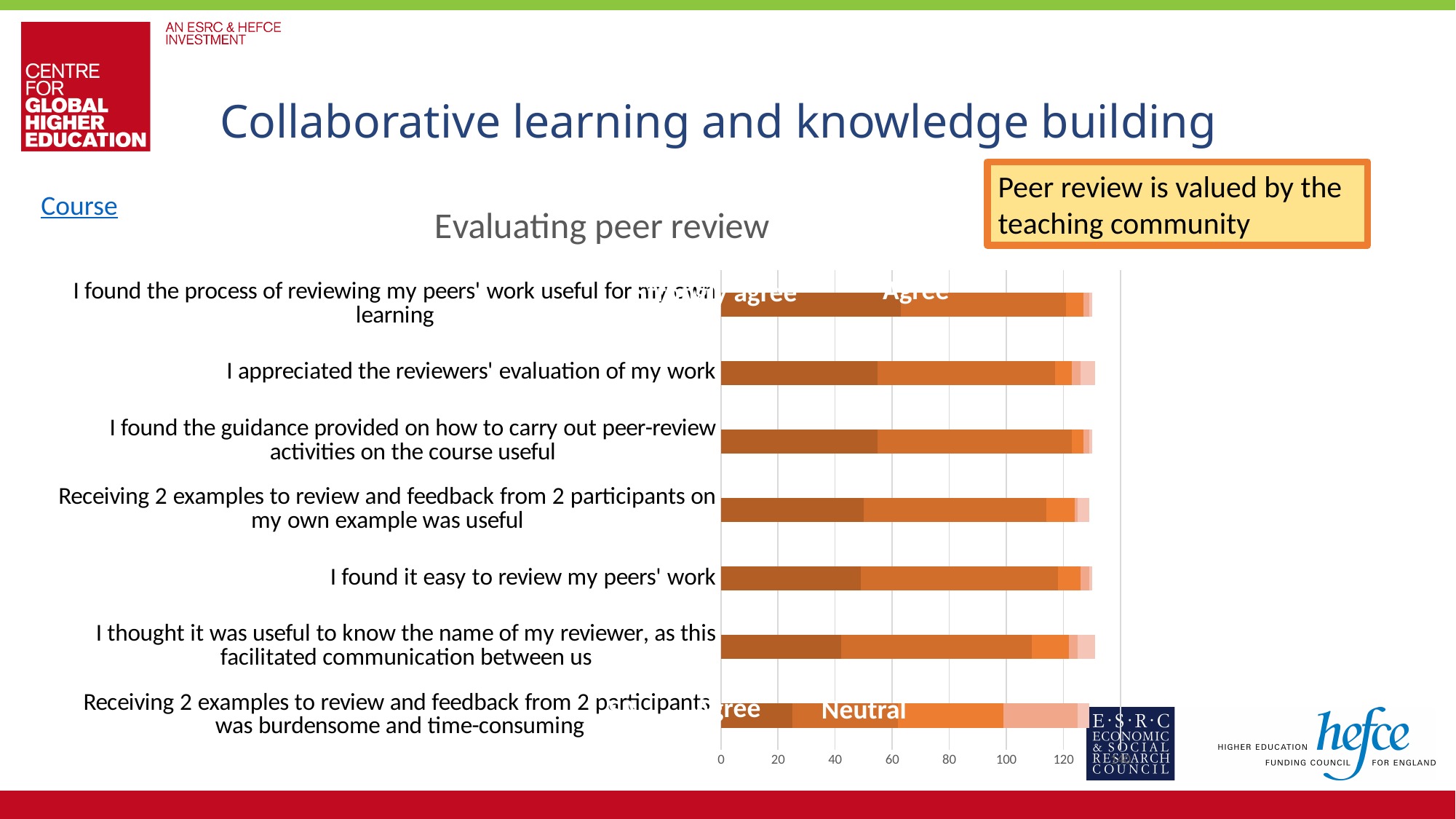
Is the total bar length for 'I found it easy to review my peers' work' greater or less than 100? greater What kind of chart is shown on the slide? Stacked bar chart Is the 'Strongly agree' value for 'Receiving 2 examples to review and feedback from 2 participants was burdensome and time-consuming' greater or less than 40? less Which statement has the shortest 'Strongly agree' segment? Receiving 2 examples to review and feedback from 2 participants was burdensome and time-consuming Which has the larger 'Strongly agree' segment: 'I found the process of reviewing my peers' work useful for my own learning' or 'I thought it was useful to know the name of my reviewer, as this facilitated communication between us'? I found the process of reviewing my peers' work useful for my own learning What is the title of the chart? Evaluating peer review How many statements (categories) are plotted in the chart? 7 What is the highest tick value shown on the horizontal axis? 120 Is the 'Strongly agree' value for 'I found the process of reviewing my peers' work useful for my own learning' greater or less than 40? greater Which statement has the longest 'Strongly agree' segment? I found the process of reviewing my peers' work useful for my own learning